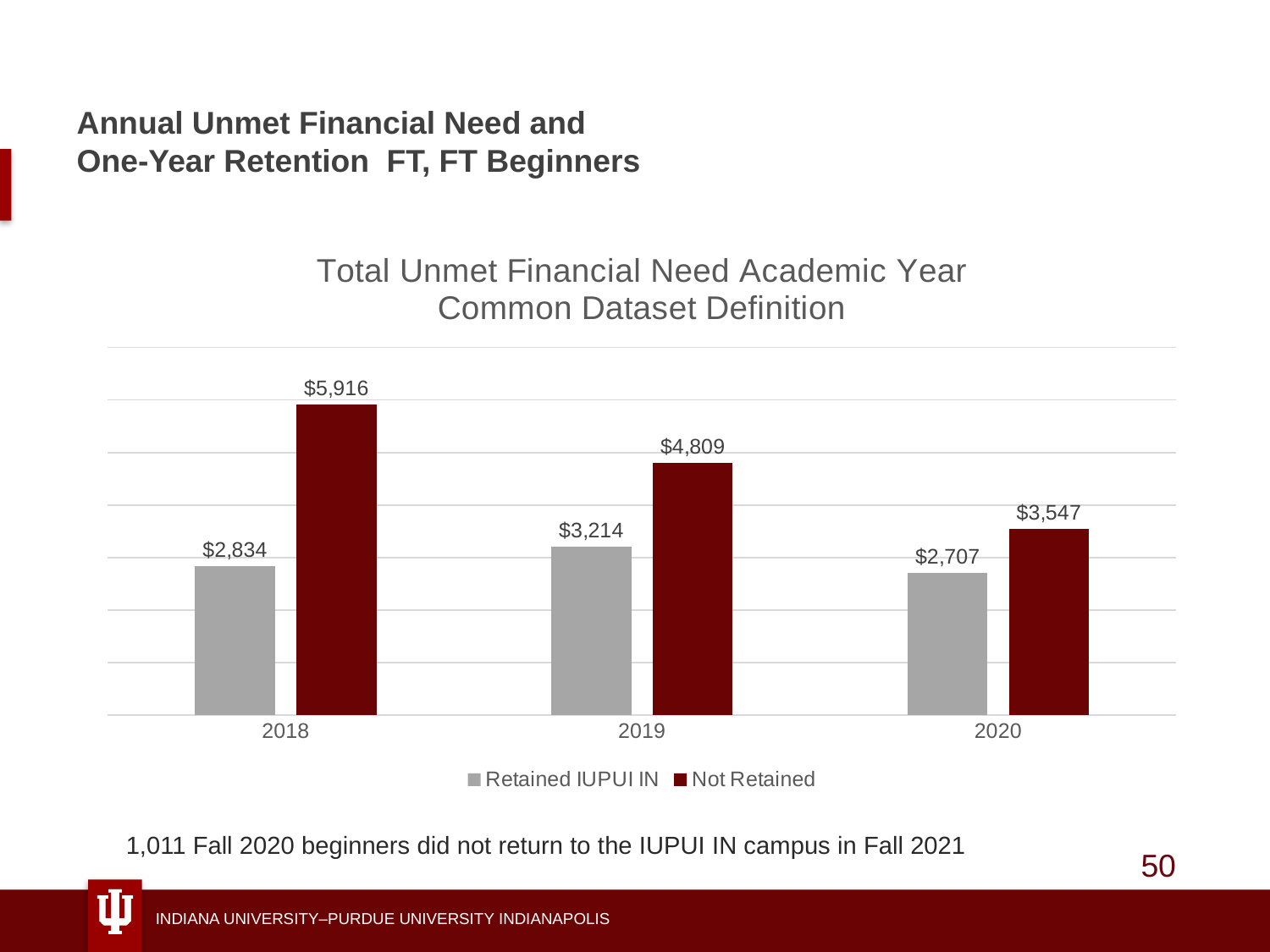
Which year has the lowest Retained IUPUI IN value? 2020 What is the Retained IUPUI IN value for 2020? $2,707 What is the Retained IUPUI IN value for 2019? $3,214 Do the Not Retained values rise or fall from 2018 to 2020? Fall What kind of chart is shown? Bar chart What is the difference between the Not Retained and Retained IUPUI IN values in 2019? $1,595 How many years are shown on the x axis? 3 Which is larger in 2020, the Retained IUPUI IN value or the Not Retained value? Not Retained What is the difference between the Not Retained values for 2018 and 2020? $2,369 How many series does the legend list? 2 Which year has the highest Not Retained value? 2018 What is the Not Retained value for 2018? $5,916